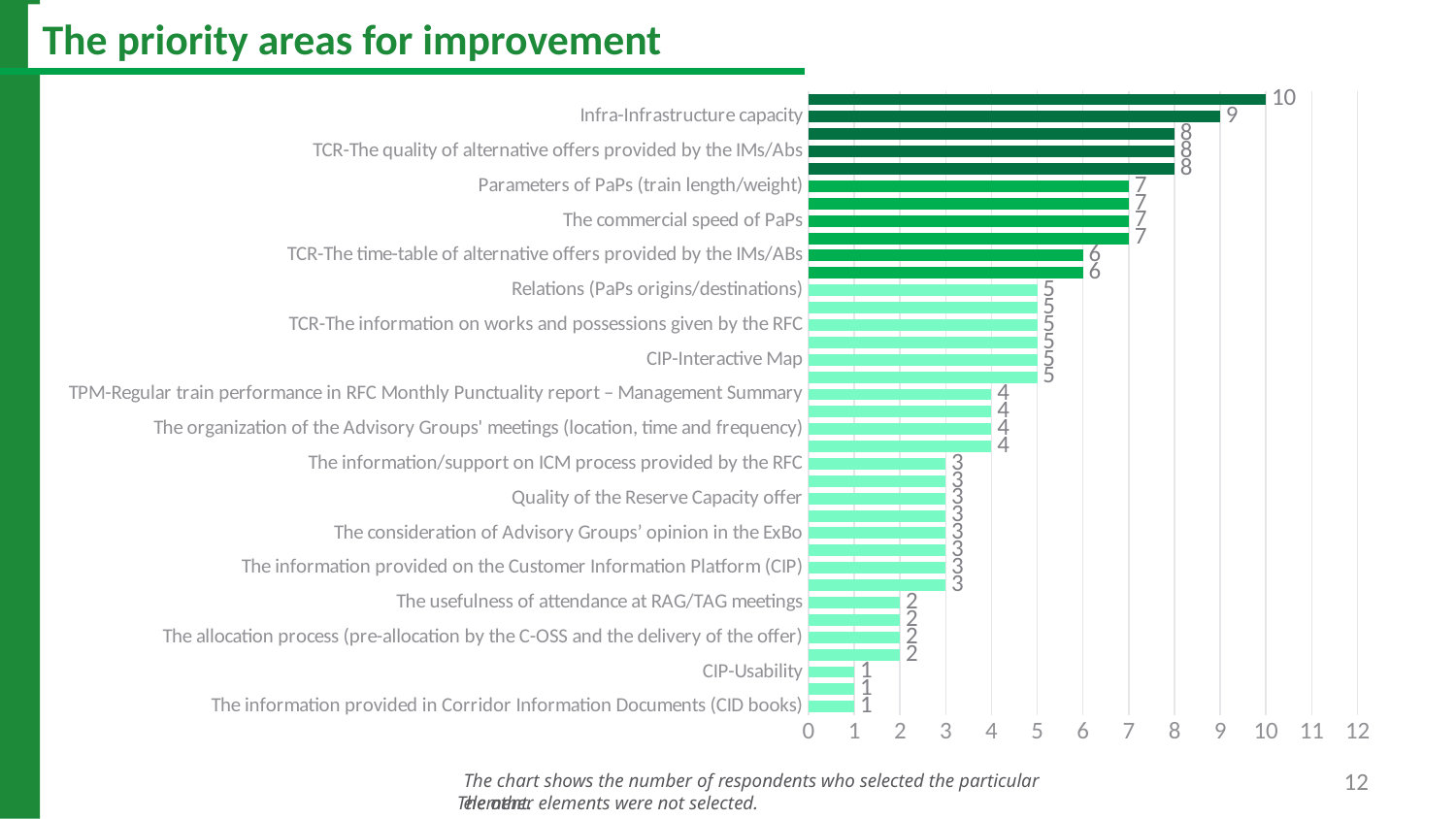
Which has a larger value: 'The commercial speed of PaPs' or 'The allocation process (pre-allocation by the C-OSS and the delivery of the offer)'? The commercial speed of PaPs What is the value for 'Quality of the Reserve Capacity offer'? 3 What is the lowest value shown on any bar in the chart? 1 What is the value for 'The commercial speed of PaPs'? 7 What is the title of the slide containing the chart? The priority areas for improvement Is the value for 'Infra-Infrastructure capacity' greater or less than 8? greater What is the difference between the value for 'TCR-The quality of alternative offers provided by the IMs/Abs' and the value for 'The information provided in Corridor Information Documents (CID books)'? 7 What kind of chart is shown on the slide? bar chart What is the value for 'The information provided in Corridor Information Documents (CID books)'? 1 What is the value for 'TCR-The quality of alternative offers provided by the IMs/Abs'? 8 What is the highest value shown on any bar in the chart? 10 What is the value for 'CIP-Interactive Map'? 5